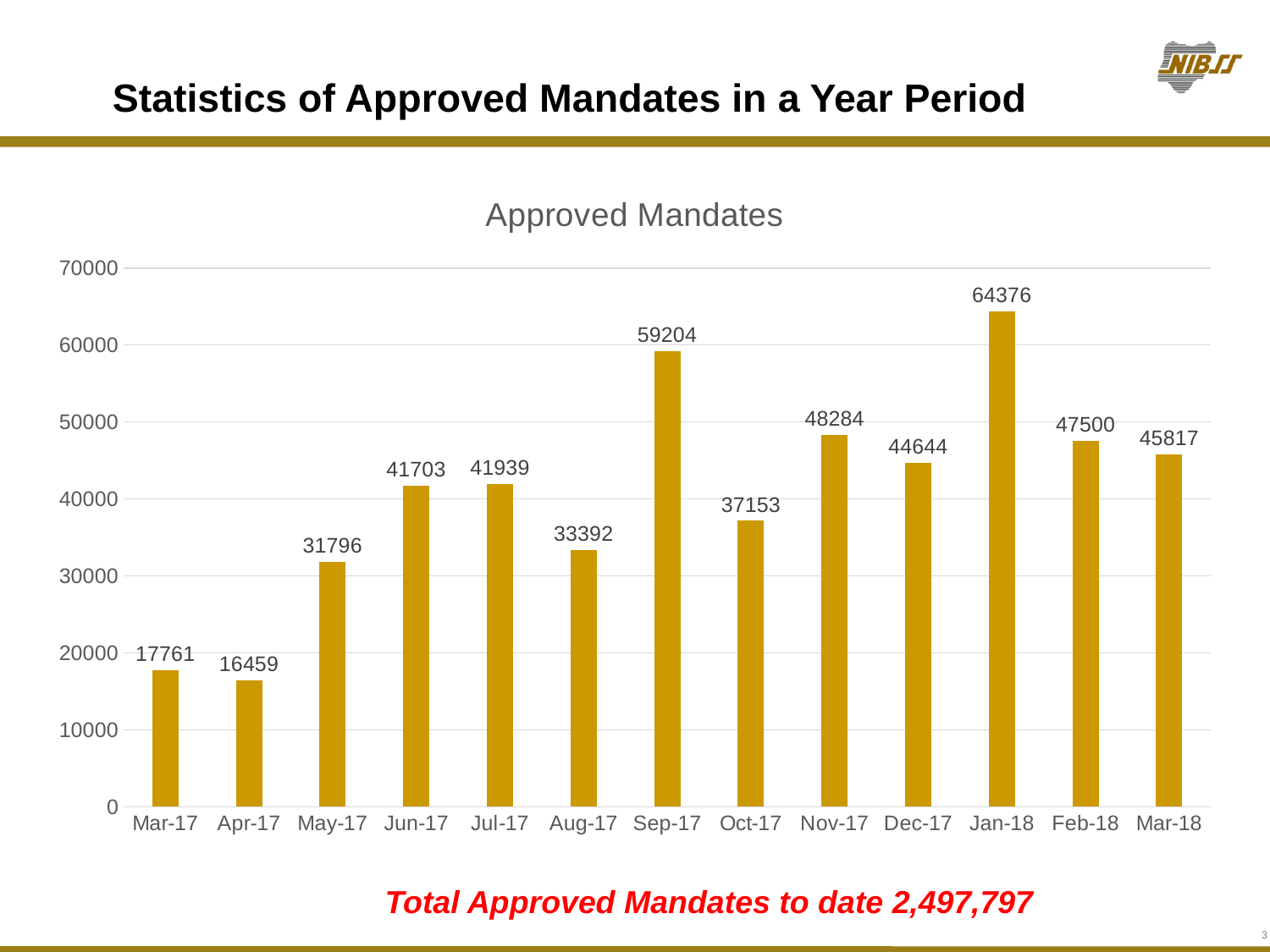
Which month has the highest number of approved mandates? Jan-18 What is the difference between the values for Jan-18 and Sep-17? 5172 Which is larger, the value for Nov-17 or the value for Dec-17? Nov-17 What is the title of the chart? Approved Mandates What is the value for Mar-18 in the Approved Mandates chart? 45817 Is the value for Oct-17 greater or less than 40000? less How many months are shown on the x axis of the chart? 13 Which month has the lowest number of approved mandates? Apr-17 What is the value for Sep-17 in the Approved Mandates chart? 59204 What kind of chart is shown on the slide? bar chart What is the value for Dec-17 in the Approved Mandates chart? 44644 What is the difference between the values for Feb-18 and Mar-18? 1683